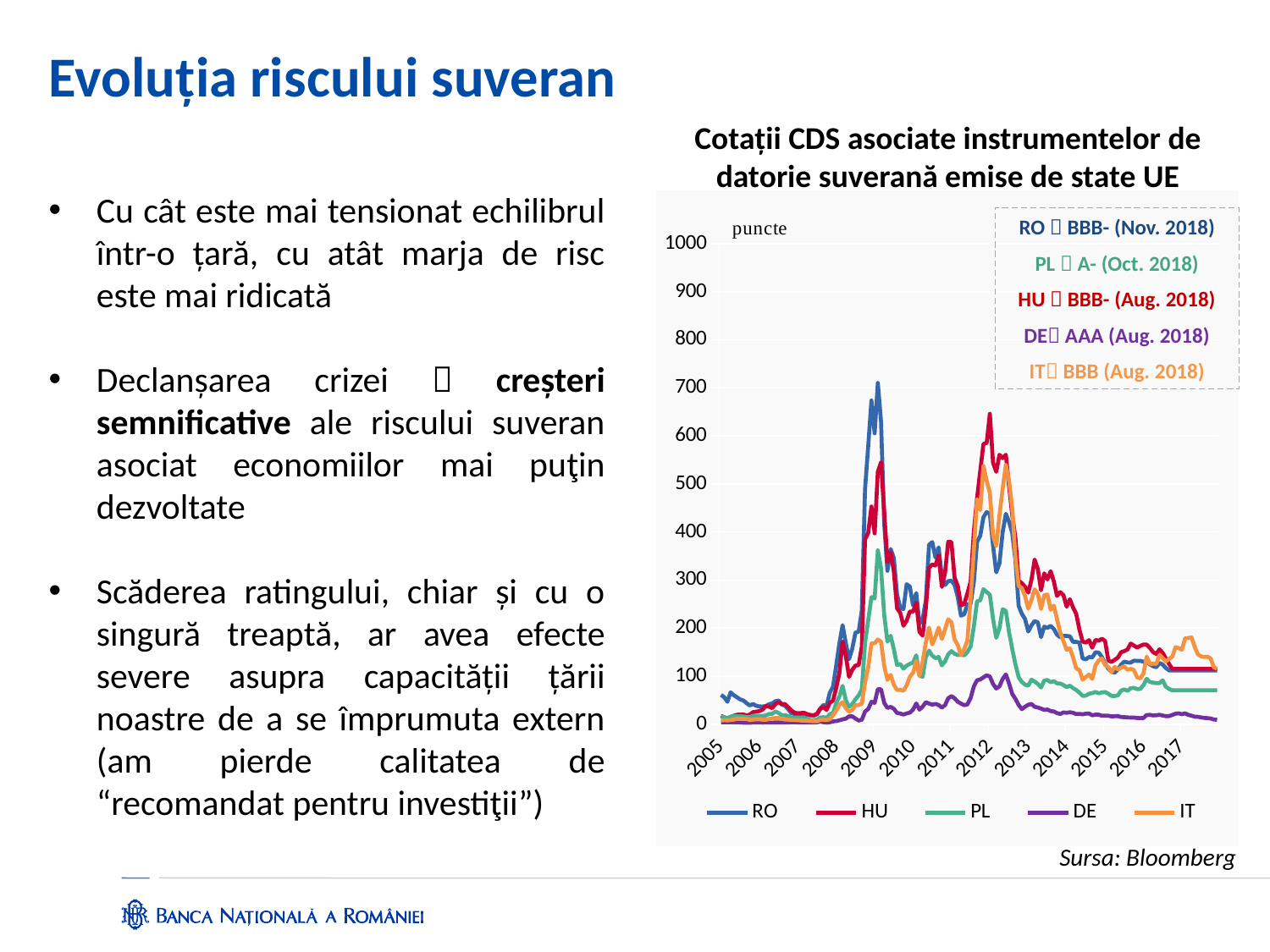
Which series stays lowest across the whole period shown in the chart? DE What unit is indicated at the top of the vertical axis of the chart? puncte Which series are listed in the chart legend? RO, HU, PL, DE, IT How many series does the chart legend list? 5 Is the value of the PL series at the end of the period (2017) greater or less than 100? less Is the peak value of the RO series in 2009 greater or less than 600? greater Is the peak value of the HU series in 2012 greater or less than 600? greater What kind of chart is shown on the slide? line chart Which series is higher in 2012, HU or PL? HU Which series reaches the highest peak in 2009 in the chart? RO How many year labels are shown on the horizontal axis of the chart? 13